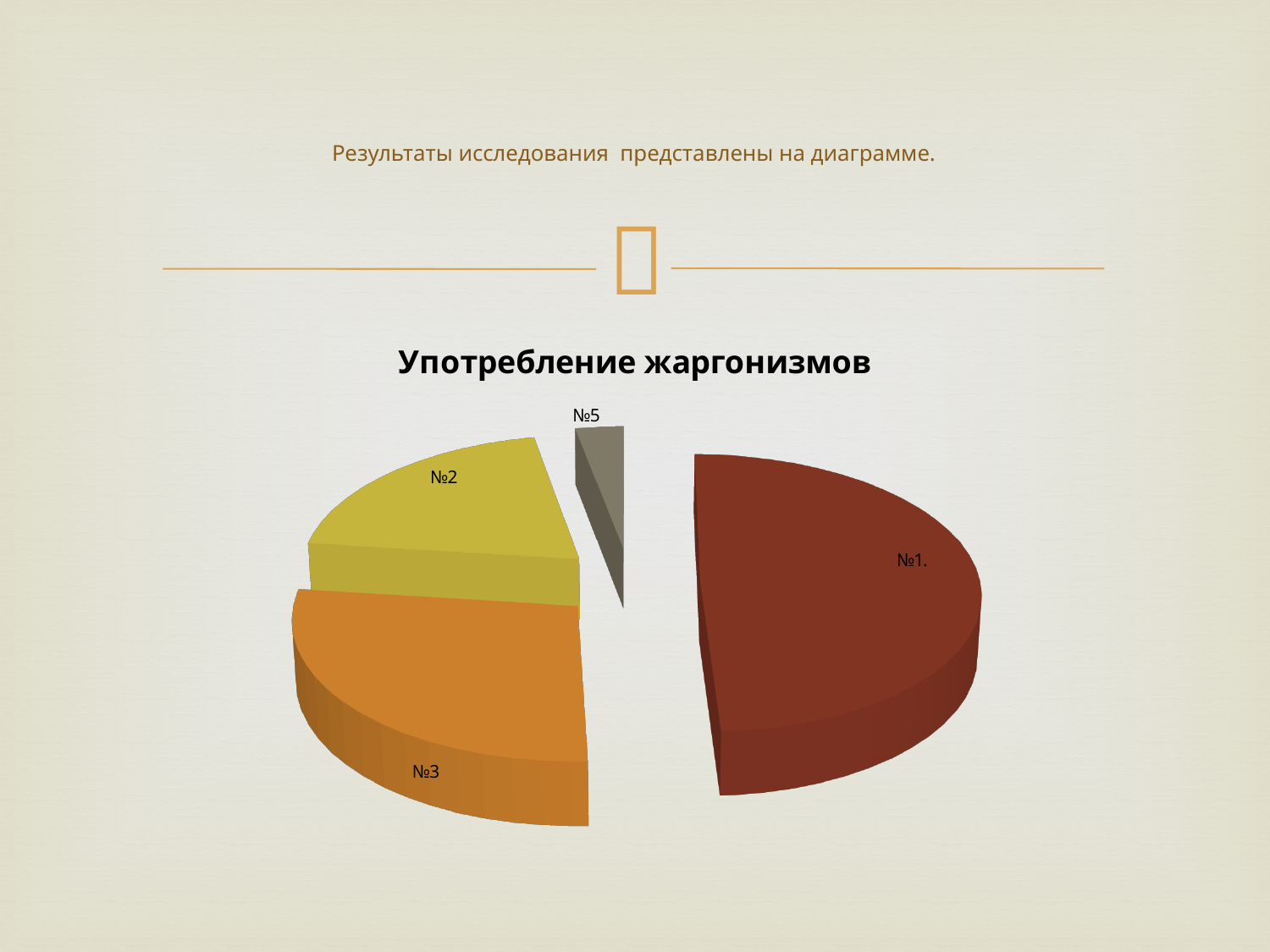
Which slice is larger, №2 or №5? №2 How many slices does the pie chart have? 4 What is the title of the chart? Употребление жаргонизмов Which slice is larger, №3 or №5? №3 Which slice is larger, №3 or №2? №3 What colour is the slice labelled №1.? dark red Which slice is the largest in the pie chart? №1. What kind of chart is shown on the slide? pie chart Which slice is the smallest in the pie chart? №5